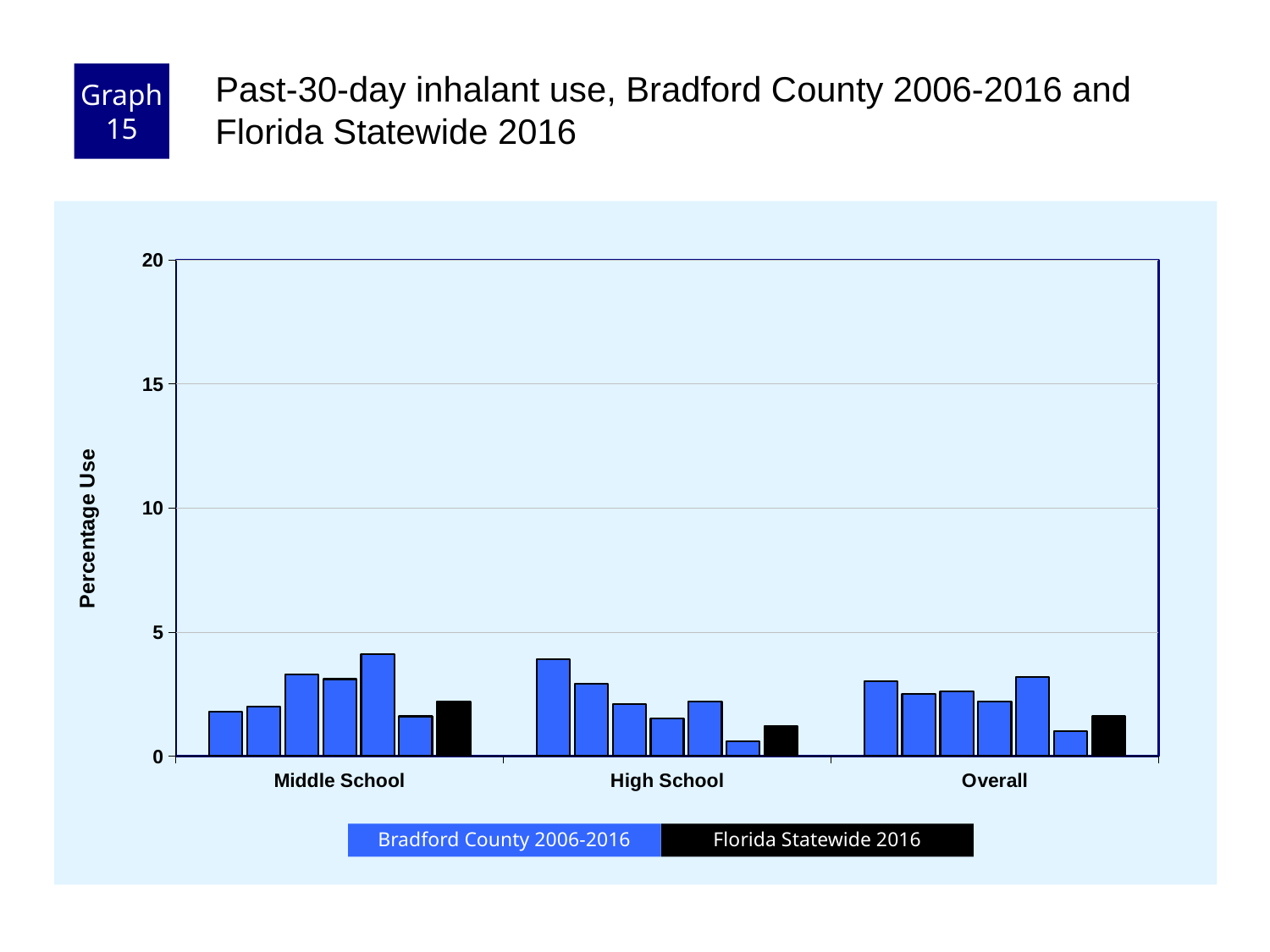
Is the Florida Statewide 2016 value for Overall greater or less than 5? less What is the label on the y axis? Percentage Use Is the Florida Statewide 2016 value for Middle School greater or less than 5? less Is the tallest bar in the Middle School group greater or less than 5? less How many bars are plotted in the Middle School group? 7 Which colour represents Florida Statewide 2016 in the legend? black What kind of chart is shown on the slide? bar chart Which category has the smaller Florida Statewide 2016 value, High School or Overall? High School How many categories are shown along the x axis? 3 How many series does the legend list? 2 Which category has the larger Florida Statewide 2016 value, Middle School or High School? Middle School